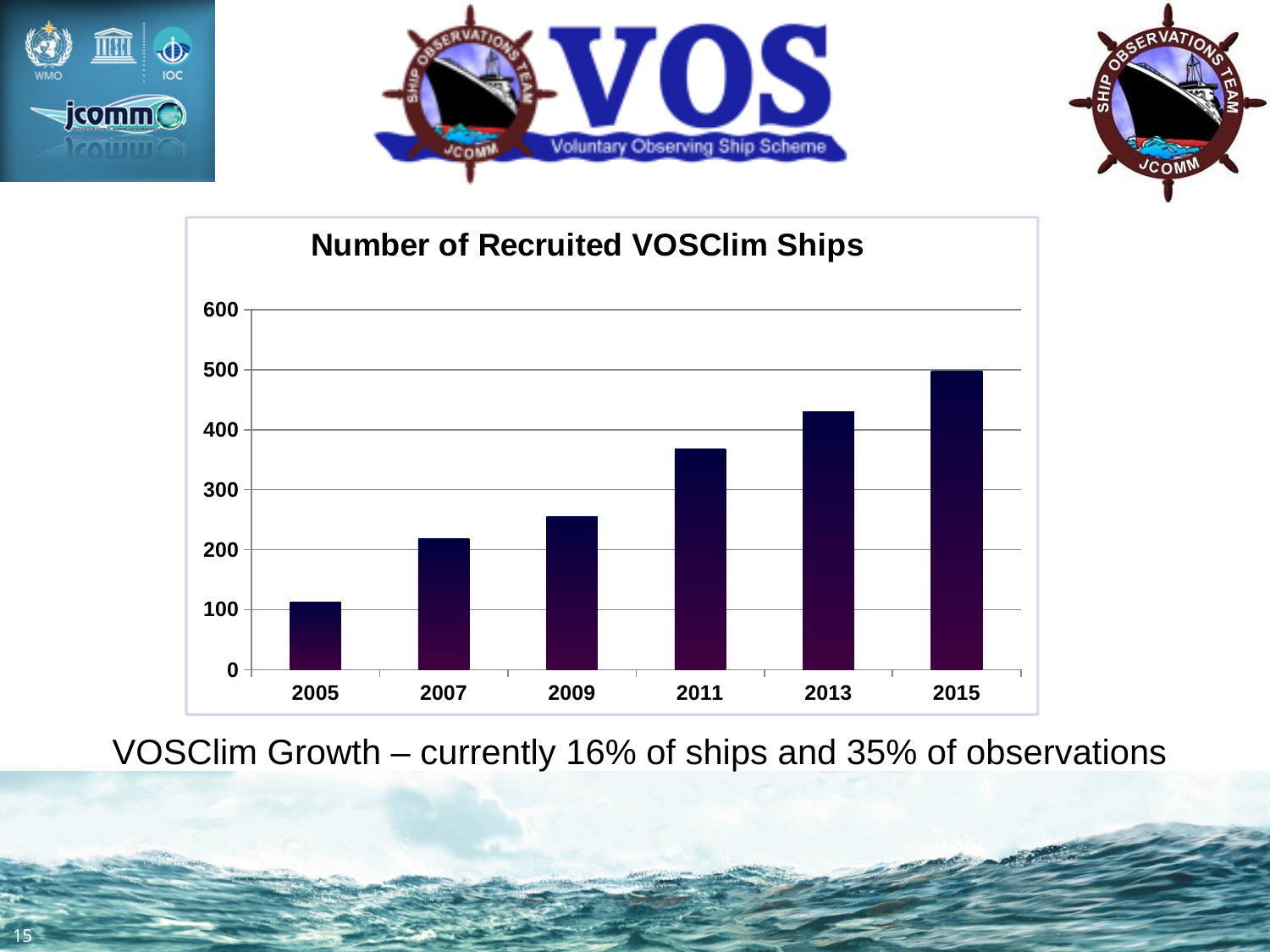
Is the value for 2011 greater or less than 400? less Is the value for 2013 greater or less than 400? greater What is the title of the chart? Number of Recruited VOSClim Ships Do the values rise or fall from 2005 to 2015? rise Which year has the highest number of recruited VOSClim ships? 2015 Which year has the lowest number of recruited VOSClim ships? 2005 Is the value for 2005 greater or less than 100? greater What type of chart is shown on the slide? bar chart Which year has a larger value, 2009 or 2011? 2011 How many years are shown on the x axis of the chart? 6